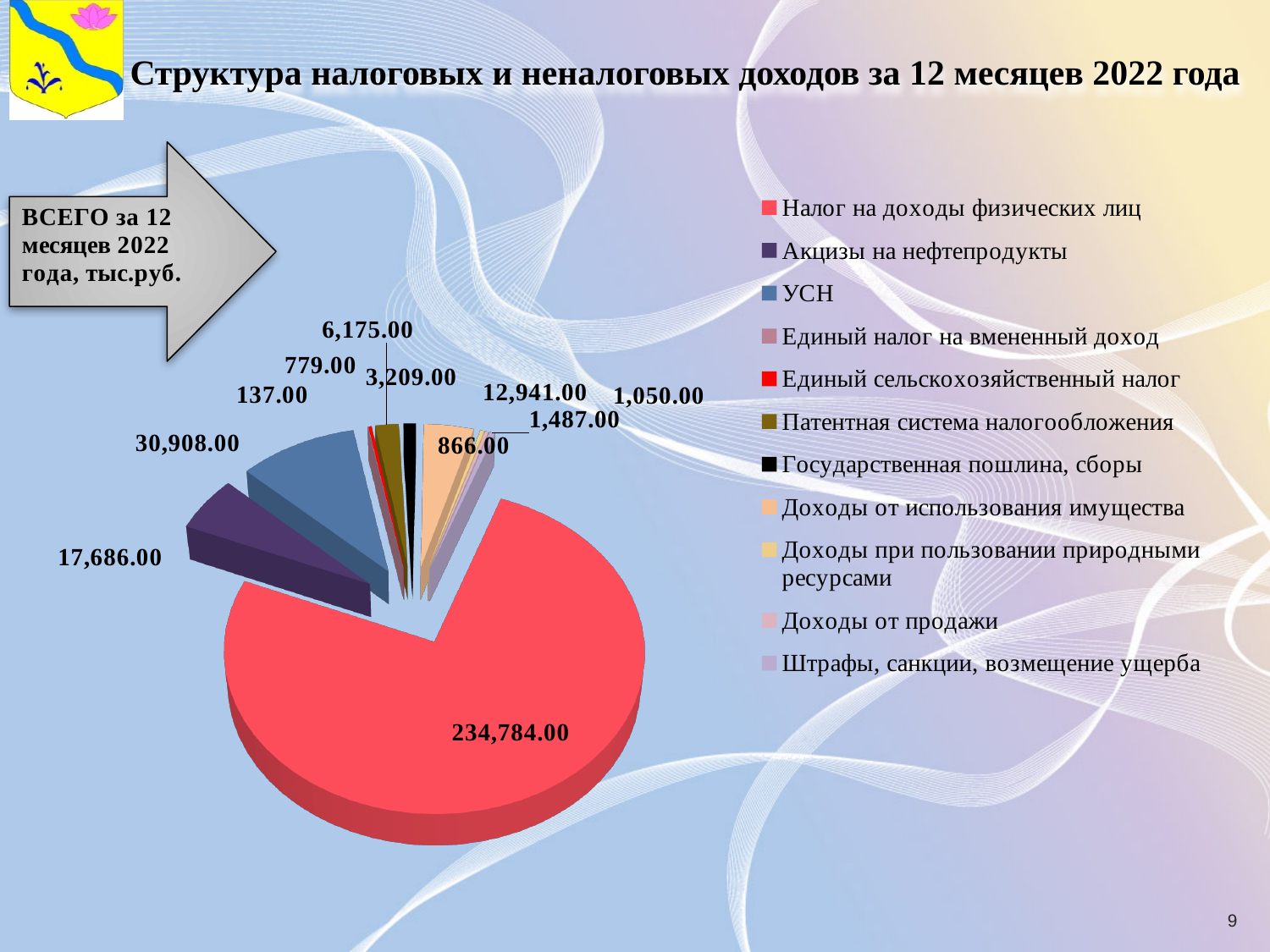
What is the value for Доходы от использования имущества? 12,941.00 What type of chart is shown on the slide? Pie chart How many categories does the legend of the pie chart list? 11 What is the value for Налог на доходы физических лиц? 234,784.00 Which is larger, УСН or Акцизы на нефтепродукты? УСН What is the value for Государственная пошлина, сборы? 3,209.00 What is the value for Патентная система налогообложения? 6,175.00 What is the value for УСН? 30,908.00 What is the value for Акцизы на нефтепродукты? 17,686.00 What is the title of the slide containing the pie chart? Структура налоговых и неналоговых доходов за 12 месяцев 2022 года Which category has the largest slice of the pie? Налог на доходы физических лиц What is the difference between the values for УСН and Акцизы на нефтепродукты? 13,222.00